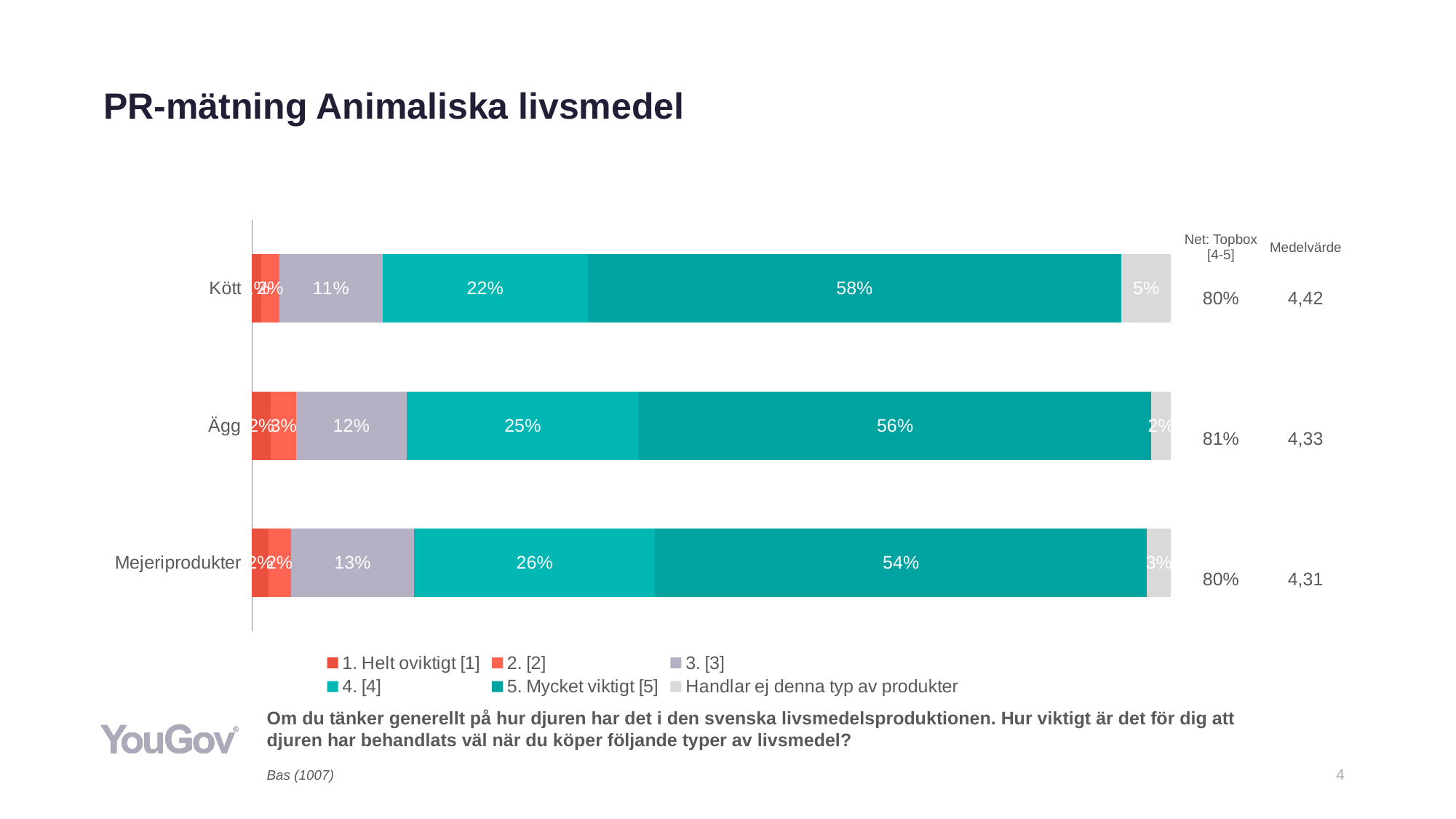
What kind of chart is shown on the slide? Stacked bar chart Which category has the highest value for "5. Mycket viktigt [5]"? Kött What is the value of "4. [4]" for Mejeriprodukter? 26% What is the Medelvärde shown for Ägg? 4,33 What is the value of "3. [3]" for Ägg? 12% What is the value of "Handlar ej denna typ av produkter" for Kött? 5% How many series does the legend list? 6 What is the value of "5. Mycket viktigt [5]" for Kött? 58% Which is larger: the "4. [4]" value for Ägg or for Kött? Ägg Which category has the lowest value for "3. [3]"? Kött What is the difference between the "5. Mycket viktigt [5]" values for Kött and Mejeriprodukter? 4% How many categories are plotted on the chart? 3